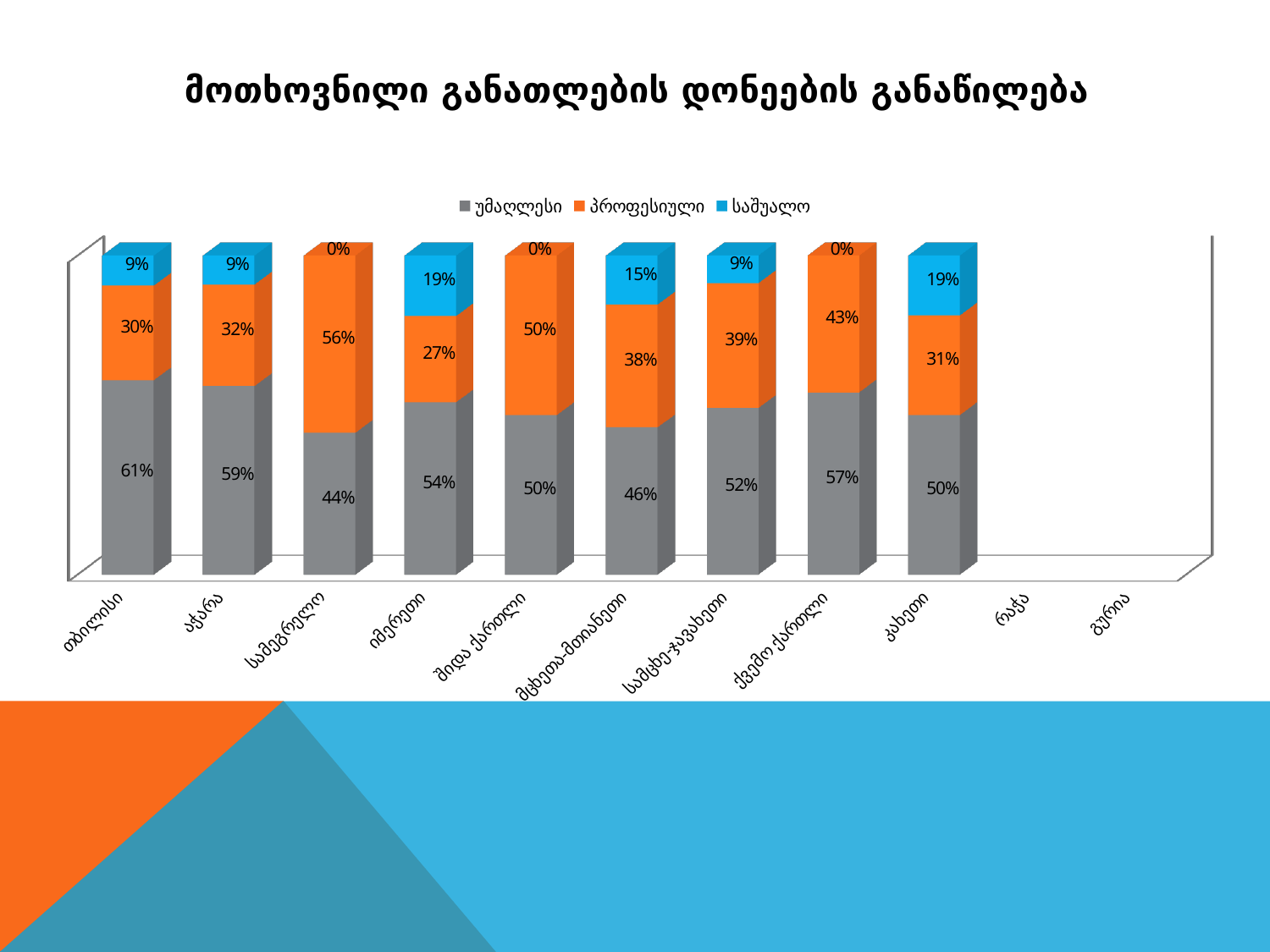
What is the difference between the უმაღლესი values for თბილისი and აჭარა? 2% What is the value of უმაღლესი for თბილისი? 61% Which category has the highest უმაღლესი value? თბილისი Which is larger: the პროფესიული value for მცხეთა-მთიანეთი or for სამცხე-ჯავახეთი? სამცხე-ჯავახეთი What is the total of the stacked bar for კახეთი? 100% How many series does the legend list? 3 What is the value of პროფესიული for სამეგრელო? 56% Which series is shown in orange in the legend? პროფესიული What is the value of პროფესიული for ქვემო ქართლი? 43% What kind of chart is shown on the slide? Stacked bar chart Which category has the lowest უმაღლესი value? სამეგრელო What is the value of საშუალო for იმერეთი? 19%